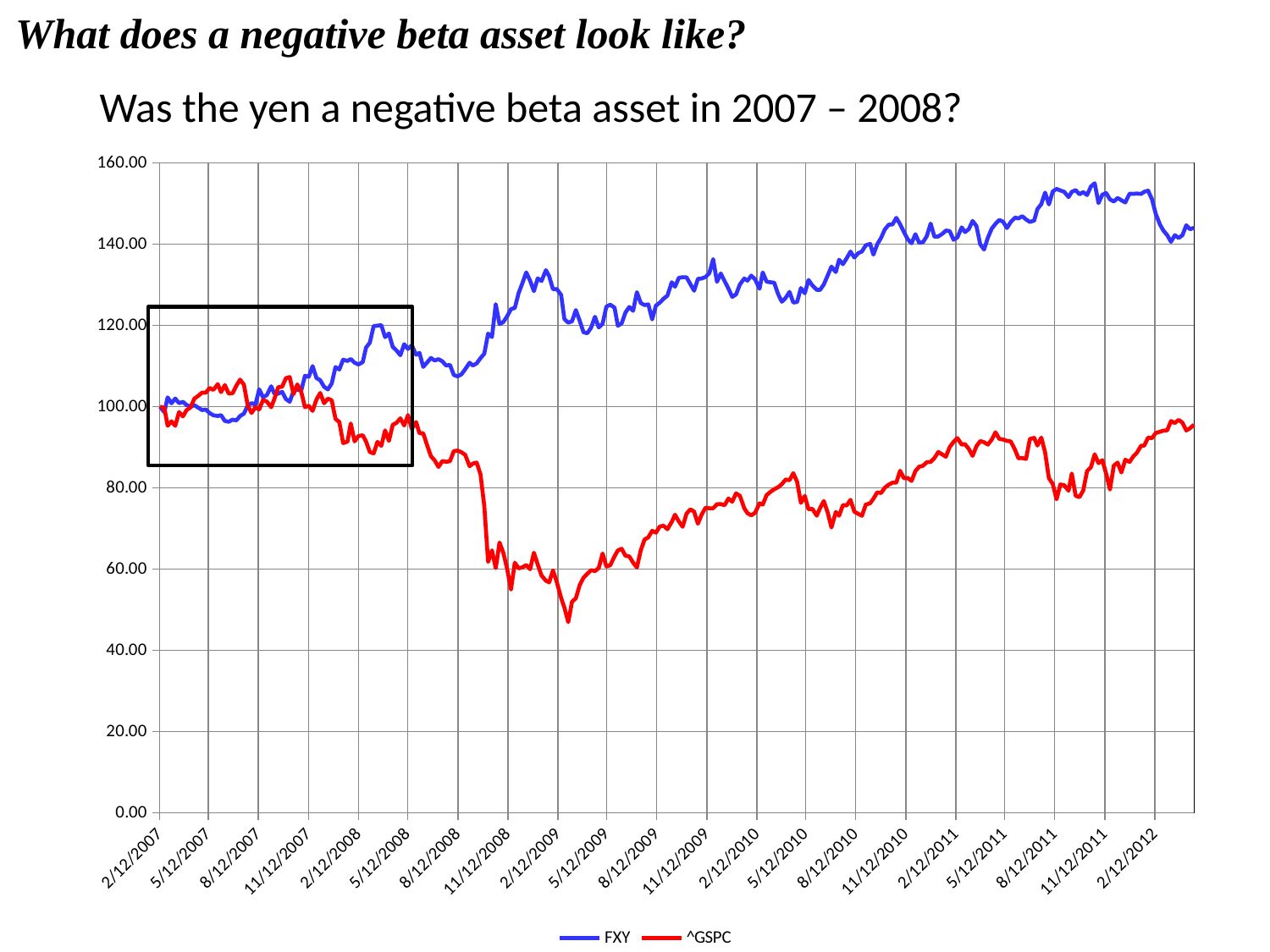
Is the value of FXY at 2/12/2012 greater or less than 140? greater Which two series are listed in the legend? FXY and ^GSPC What is the highest value shown on the vertical axis? 160.00 Is the value of FXY at 8/12/2008 greater or less than 120? less Is the value of ^GSPC at 2/12/2009 greater or less than 80? less How many series does the legend list? 2 Does the ^GSPC line rise or fall between 2/12/2008 and 2/12/2009? fall What colour is the FXY line? blue What kind of chart is shown on the slide? line chart At 2/12/2010, which series has the higher value, FXY or ^GSPC? FXY At 8/12/2007, which series has the higher value, FXY or ^GSPC? FXY